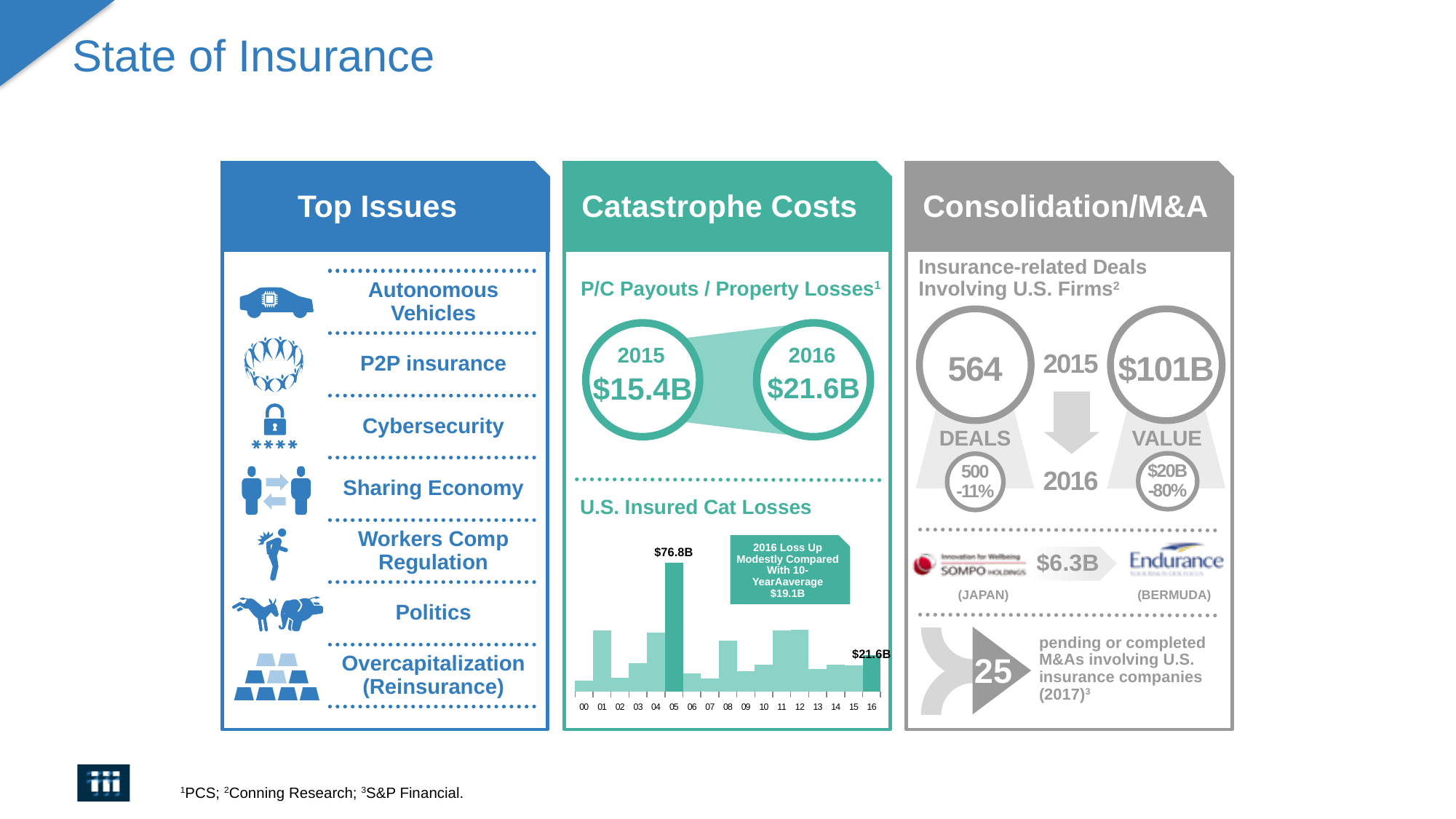
How many years (bars) are shown in the U.S. Insured Cat Losses chart? 17 According to the annotation on the U.S. Insured Cat Losses chart, what is the 10-year average loss? $19.1B In the U.S. Insured Cat Losses chart, what is the value labeled for 05? $76.8B In the U.S. Insured Cat Losses chart, what is the value labeled for 16? $21.6B In the U.S. Insured Cat Losses chart, which year has the larger value, 01 or 02? 01 What kind of chart is the U.S. Insured Cat Losses chart? bar chart What is the title of the bar chart in the Catastrophe Costs panel? U.S. Insured Cat Losses In the U.S. Insured Cat Losses chart, what is the difference between the labeled values for 05 and 16? $55.2B In the U.S. Insured Cat Losses chart, which year has the larger value, 08 or 09? 08 In the U.S. Insured Cat Losses chart, which year has the larger value, 05 or 16? 05 In the U.S. Insured Cat Losses chart, which year has the highest bar? 05